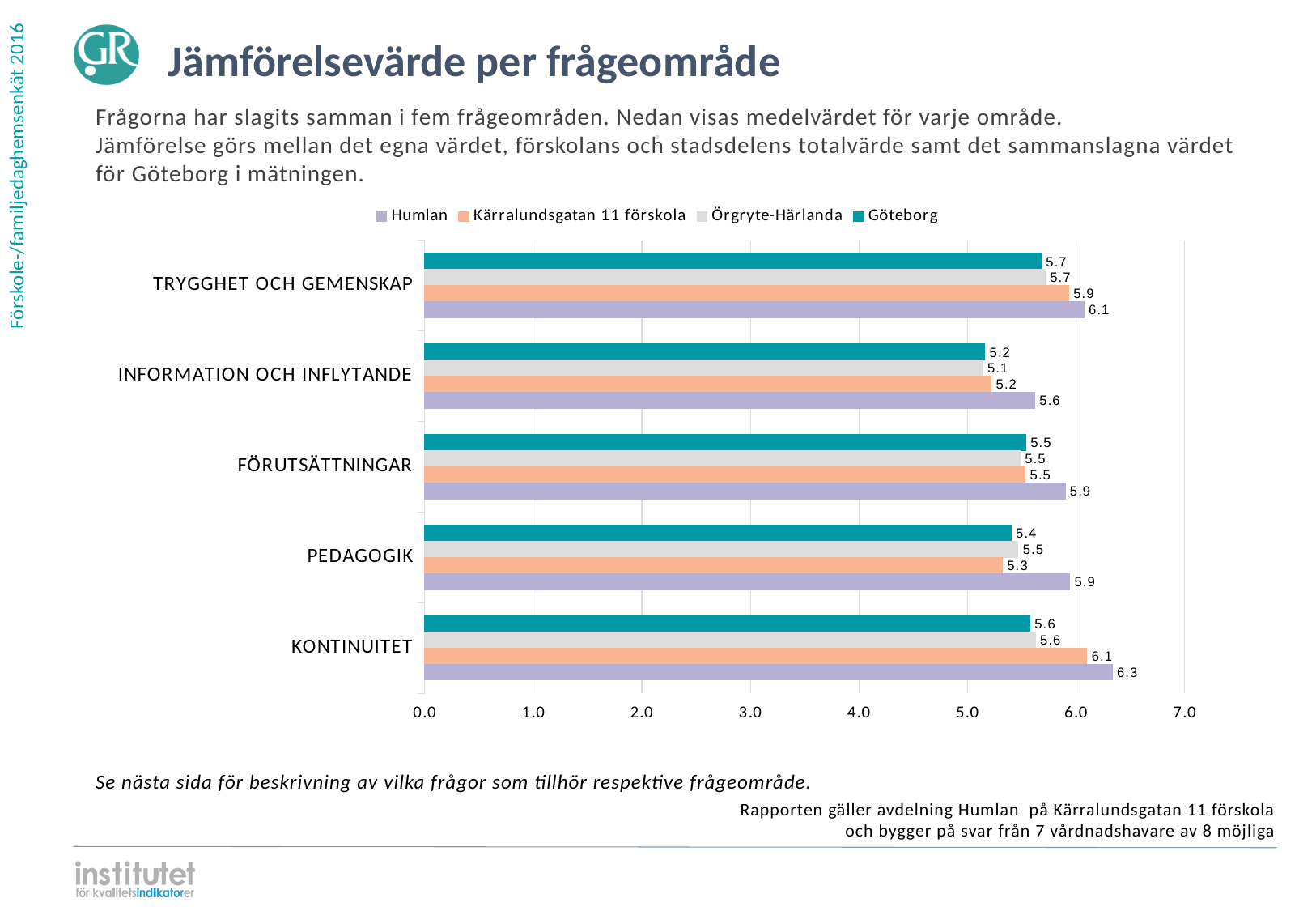
What kind of chart is shown on the slide? Bar chart In which category does Humlan have its highest value? KONTINUITET What is the value for Göteborg in the PEDAGOGIK category? 5.4 Which is larger in the KONTINUITET category: the value for Kärralundsgatan 11 förskola or the value for Örgryte-Härlanda? Kärralundsgatan 11 förskola How many series does the legend list? 4 What is the value for Örgryte-Härlanda in the TRYGGHET OCH GEMENSKAP category? 5.7 In which category does Humlan have its lowest value? INFORMATION OCH INFLYTANDE What is the value for Kärralundsgatan 11 förskola in the INFORMATION OCH INFLYTANDE category? 5.2 What is the difference between the Humlan value and the Göteborg value in the PEDAGOGIK category? 0.5 What is the title of the slide containing the chart? Jämförelsevärde per frågeområde What is the value for Humlan in the KONTINUITET category? 6.3 How many categories are shown on the y axis of the chart? 5